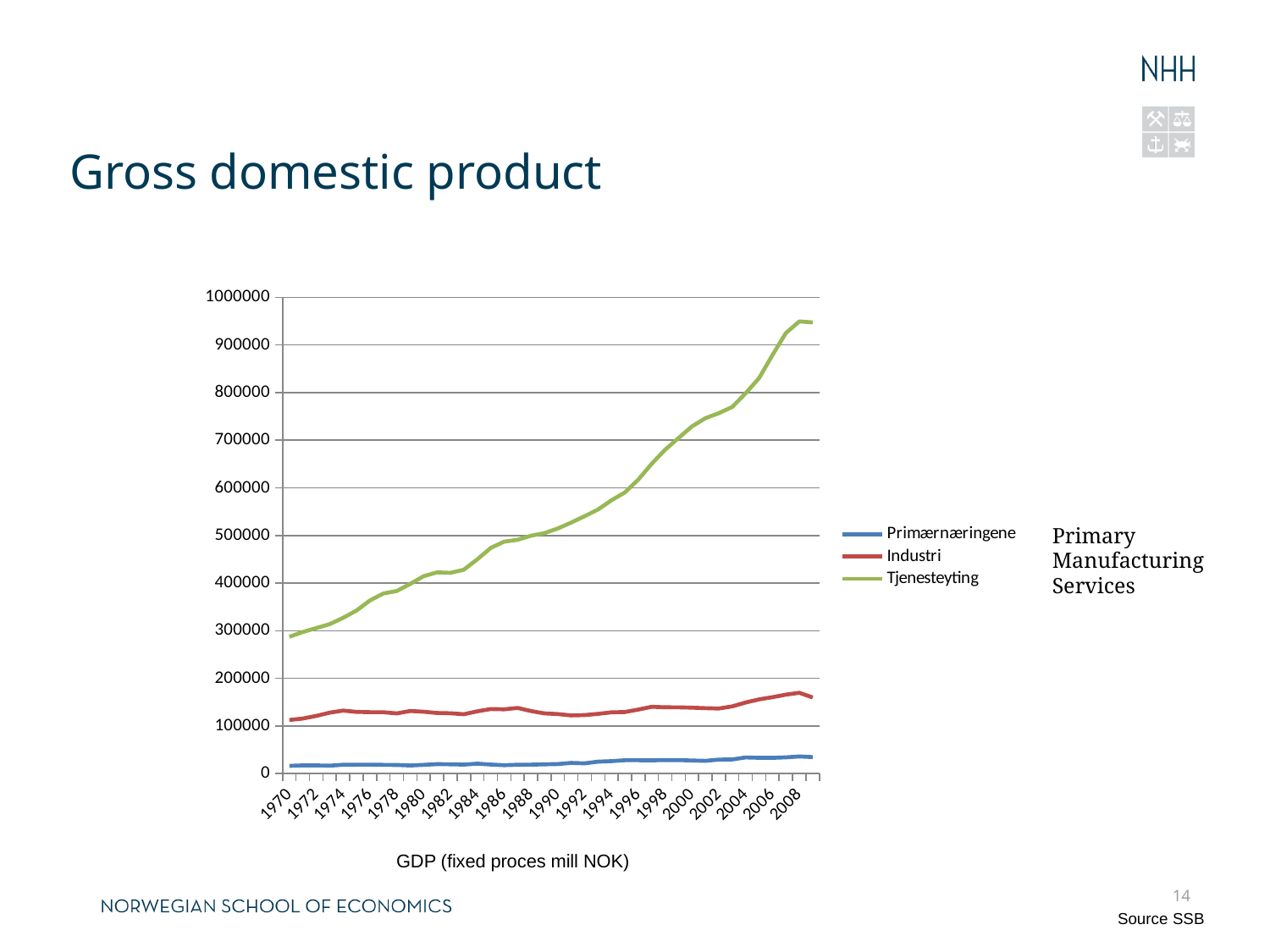
Is the value for Tjenesteyting in 1970 greater or less than 400000? less Does the value for Tjenesteyting rise or fall from 1970 to 2008? rise Is the value for Primærnæringene in 2008 greater or less than 100000? less What kind of chart is shown on the slide? line chart Which series has the lowest values throughout the chart? Primærnæringene Which is larger in 2000, the value for Industri or the value for Primærnæringene? Industri What colour is the line for Industri? red How many year labels are shown on the x axis? 20 Is the value for Industri in 2008 greater or less than 200000? less Which series has the highest values throughout the chart? Tjenesteyting How many series does the legend list? 3